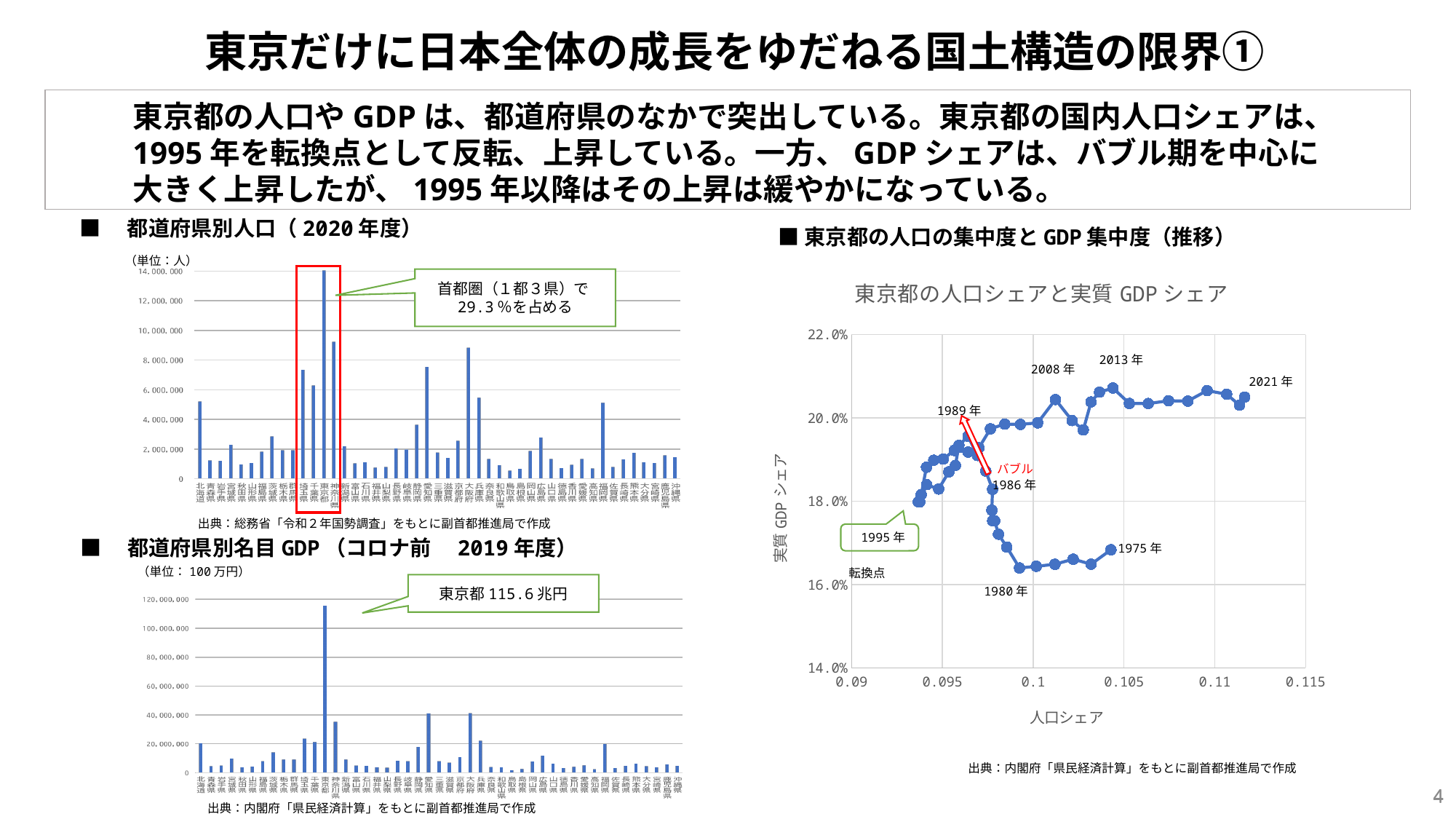
What unit is shown for the 都道府県別名目GDP（コロナ前 2019年度） chart? 100万円 In the 都道府県別人口（2020年度） chart, which is larger, the population of 東京都 or 神奈川県? 東京都 In the 都道府県別名目GDP（コロナ前 2019年度） chart, what is the nominal GDP of 東京都 as stated in the annotation? 115.6兆円 In the 東京都の人口シェアと実質GDPシェア chart on the right, is the 実質GDPシェア for 1980年 greater or less than 18.0%? less In the 都道府県別人口（2020年度） chart, is the value for 北海道 greater or less than 4,000,000? greater In the 都道府県別人口（2020年度） chart, which prefecture has the highest population? 東京都 In the 都道府県別人口（2020年度） chart, is the value for 東京都 greater or less than 12,000,000? greater In the 東京都の人口シェアと実質GDPシェア chart on the right, which year is labelled as the 転換点 (turning point)? 1995年 What kind of chart is the 都道府県別人口（2020年度） chart on the top left? bar chart According to the annotation on the 都道府県別人口（2020年度） chart, what share of the population does the 首都圏（1都3県） account for? 29.3％